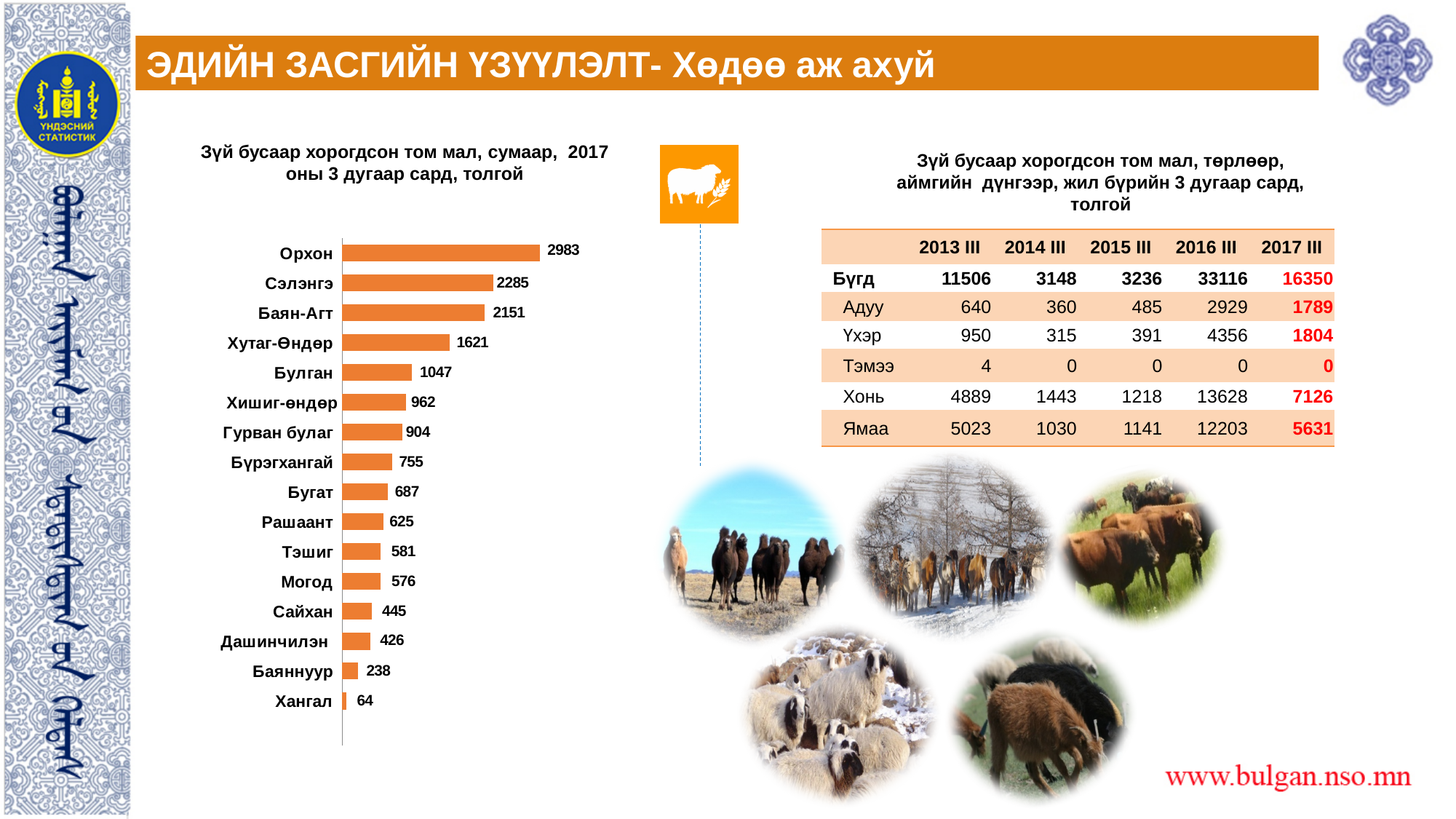
Which category has the lowest value in the bar chart? Хангал What is the value for Баяннуур in the bar chart? 238 What is the value for Орхон in the bar chart? 2983 What is the title of the bar chart? Зүй бусаар хорогдсон том мал, сумаар, 2017 оны 3 дугаар сард, толгой Which is larger in the bar chart, the value for Баян-Агт or the value for Булган? Баян-Агт How many categories are shown in the bar chart? 16 What colour are the bars in the bar chart? Orange What is the value for Хутаг-Өндөр in the bar chart? 1621 What is the difference between the values for Орхон and Сэлэнгэ in the bar chart? 698 What is the difference between the values for Булган and Хишиг-өндөр in the bar chart? 85 Which category has the highest value in the bar chart? Орхон What kind of chart is shown on the left of the slide? Bar chart